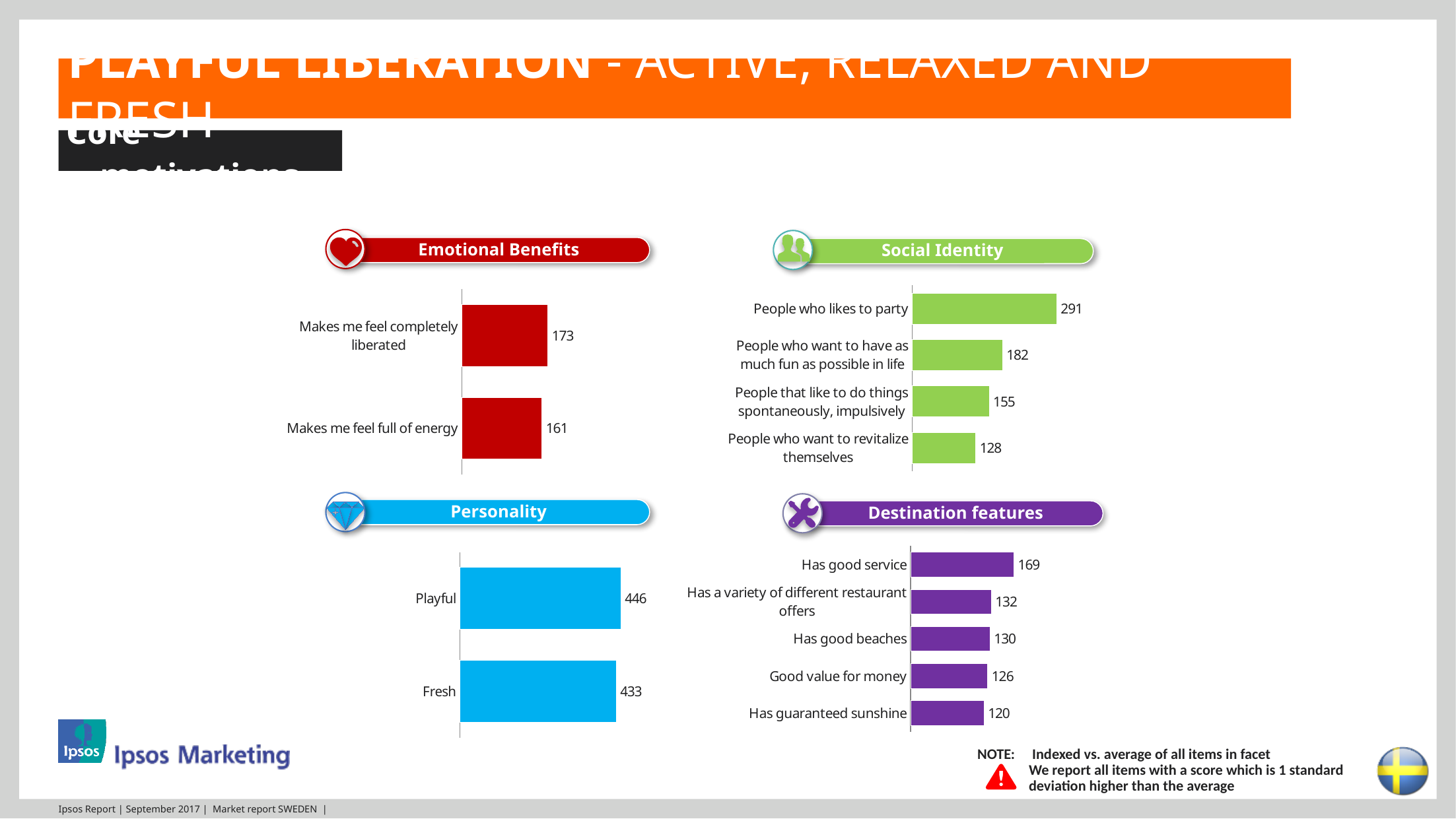
In the Social Identity chart, what is the value for "People who want to revitalize themselves"? 128 In the Destination features chart, what is the value for "Has good beaches"? 130 In the Emotional Benefits chart, what is the difference between "Makes me feel completely liberated" and "Makes me feel full of energy"? 12 In the Social Identity chart, what is the difference between "People who likes to party" and "People who want to have as much fun as possible in life"? 109 In the Destination features chart, which category has the lowest value? Has guaranteed sunshine In the Emotional Benefits chart, what is the value for "Makes me feel completely liberated"? 173 In the Personality chart, which is larger, Playful or Fresh? Playful In the Social Identity chart, which category has the highest value? People who likes to party In the Destination features chart, how many categories are shown? 5 In the Personality chart, what is the value for Fresh? 433 What type of chart is the Personality chart? Bar chart In the Social Identity chart, how many categories are shown? 4